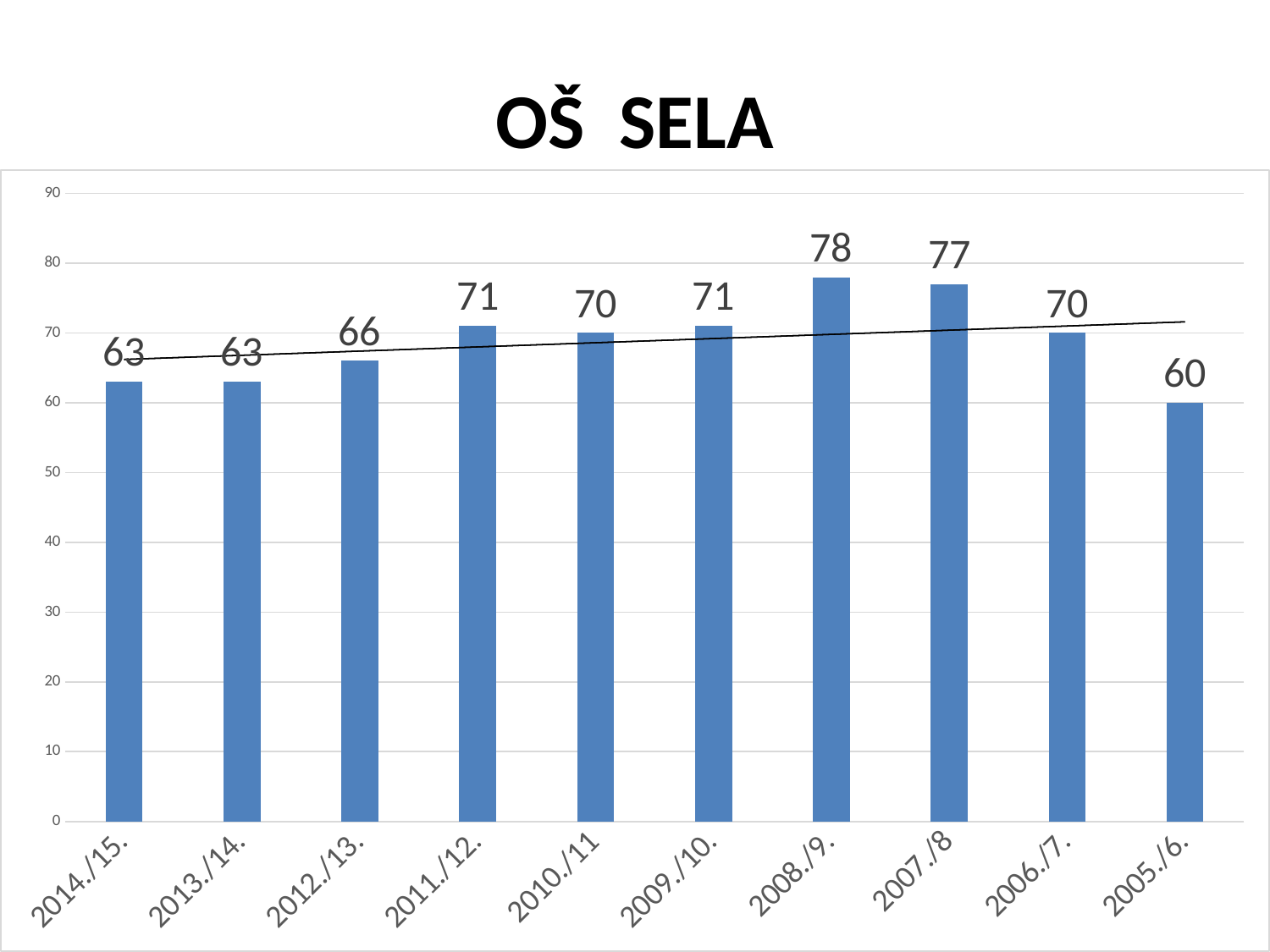
What is the value for 2005./6.? 60 What is the title of the chart? OŠ SELA Which category has the lowest value? 2005./6. What kind of chart is shown? bar chart How many categories are shown on the x axis? 10 What is the value for 2008./9.? 78 Is the value for 2013./14. greater or less than 70? less What is the value for 2012./13.? 66 Which is larger, the value for 2007./8 or the value for 2006./7.? 2007./8 What is the difference between the values for 2008./9. and 2005./6.? 18 What is the difference between the values for 2011./12. and 2014./15.? 8 Which category has the highest value? 2008./9.